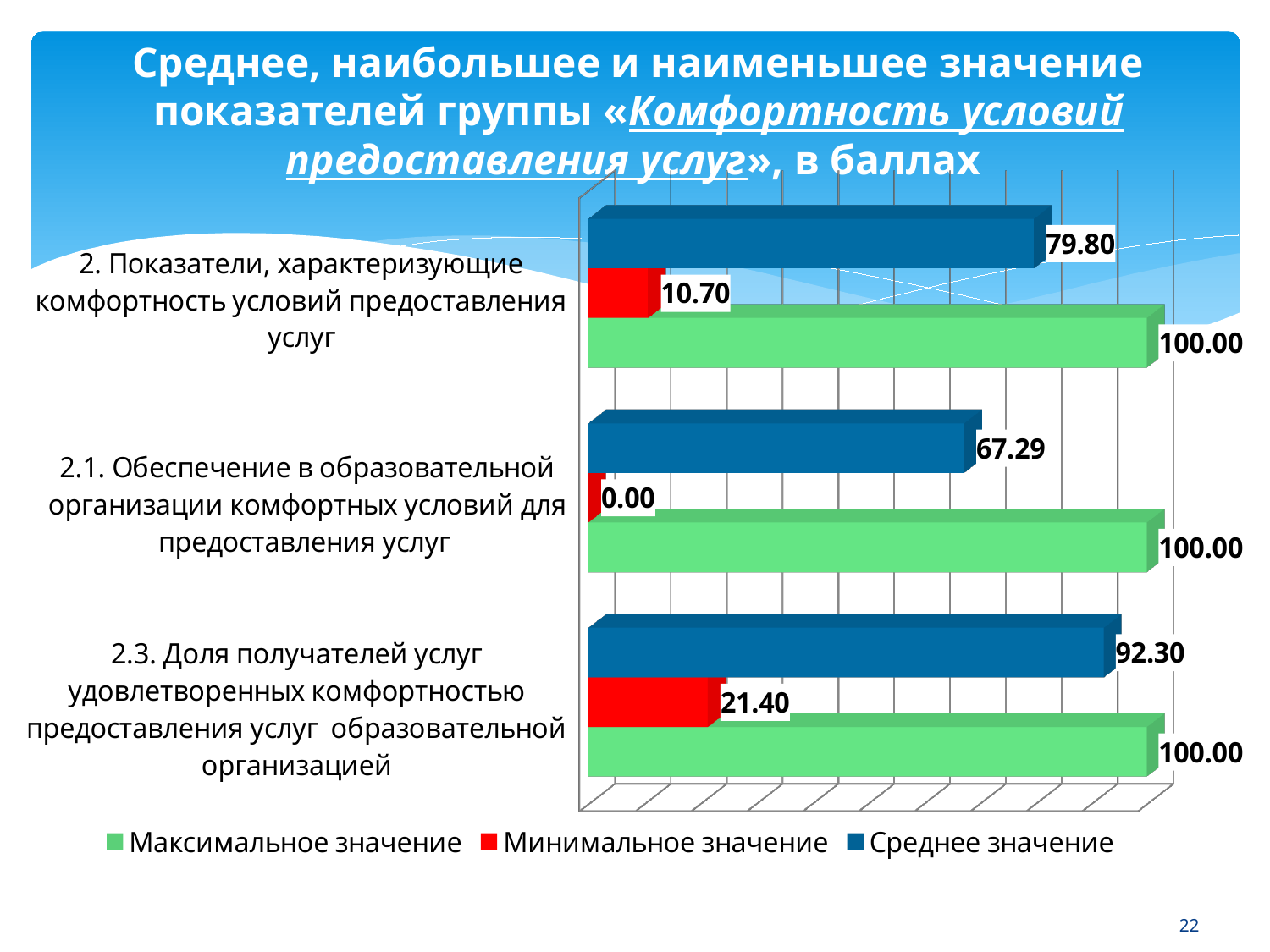
Which indicator has the lowest minimum value (Минимальное значение)? 2.1. Обеспечение в образовательной организации комфортных условий для предоставления услуг Which indicator has the highest average value (Среднее значение)? 2.3. Доля получателей услуг удовлетворенных комфортностью предоставления услуг образовательной организацией What is the average value (Среднее значение) for indicator 2.1 (Обеспечение в образовательной организации комфортных условий для предоставления услуг)? 67.29 Which is larger: the average value for indicator 2 or the average value for indicator 2.1? Indicator 2 (79.80) What is the minimum value (Минимальное значение) for indicator 2 (Показатели, характеризующие комфортность условий предоставления услуг)? 10.70 What is the difference between the average values of indicator 2.3 and indicator 2? 12.50 What is the minimum value (Минимальное значение) for indicator 2.3 (Доля получателей услуг удовлетворенных комфортностью предоставления услуг образовательной организацией)? 21.40 What is the maximum value (Максимальное значение) for indicator 2.1? 100.00 What type of chart is shown on the slide? Bar chart What is the difference between the maximum and average values for indicator 2.1? 32.71 How many indicators (categories) are shown on the chart? 3 How many series does the legend list? 3